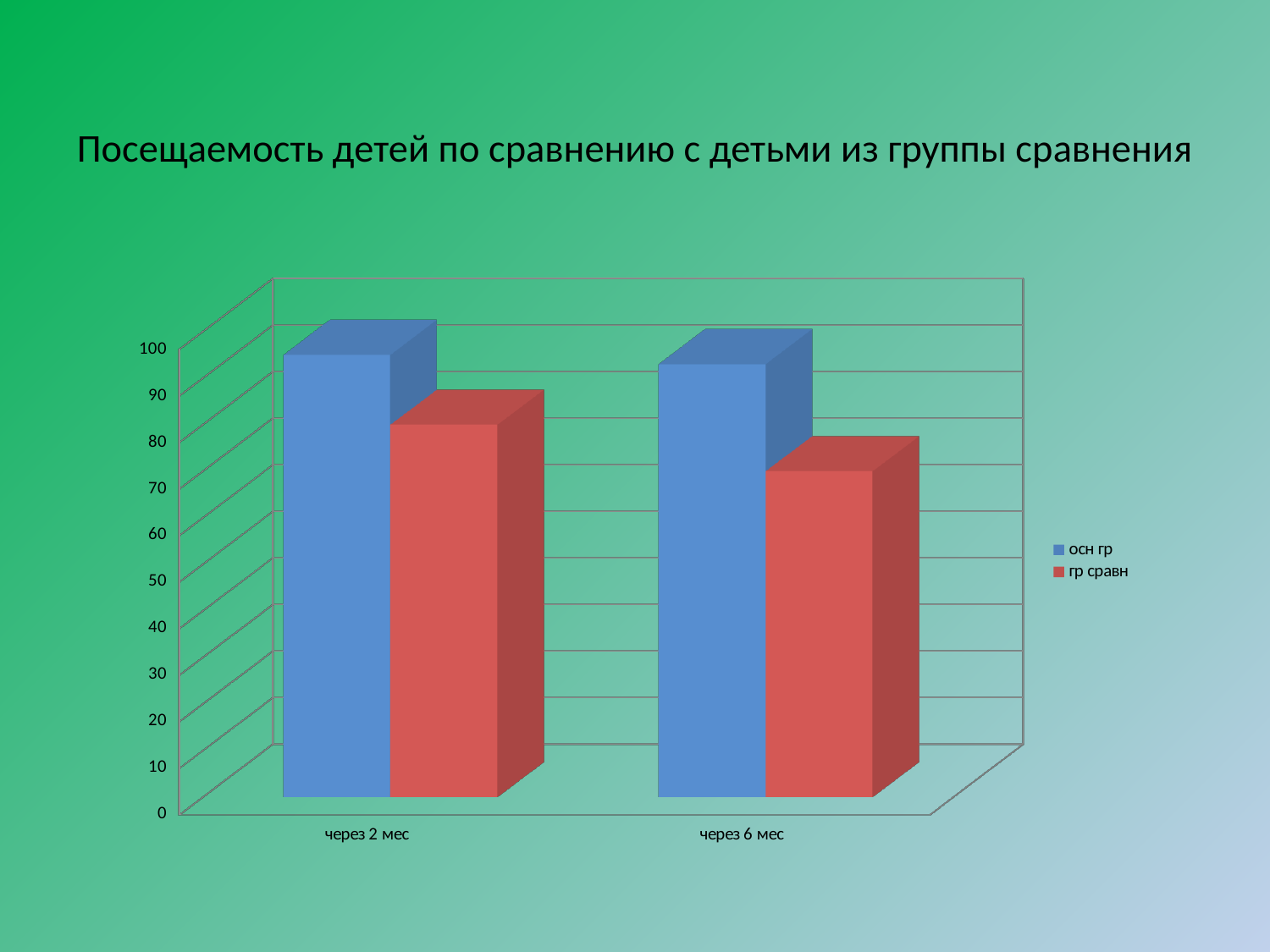
How many series does the legend list? 2 For the category 'через 2 мес', which series has the larger value, 'осн гр' or 'гр сравн'? осн гр How many categories are shown on the x axis? 2 For the category 'через 6 мес', which series has the larger value, 'осн гр' or 'гр сравн'? осн гр Is the value for 'гр сравн' at 'через 6 мес' greater or less than 80? less What is the title of the chart? Посещаемость детей по сравнению с детьми из группы сравнения What kind of chart is shown on the slide? bar chart Which series is shown in red? гр сравн Is the value for 'гр сравн' at 'через 2 мес' greater or less than 70? greater Is the value for 'осн гр' at 'через 2 мес' greater or less than 90? greater Does the value for 'гр сравн' rise or fall from 'через 2 мес' to 'через 6 мес'? fall Which bar is the lowest on the chart? гр сравн at через 6 мес